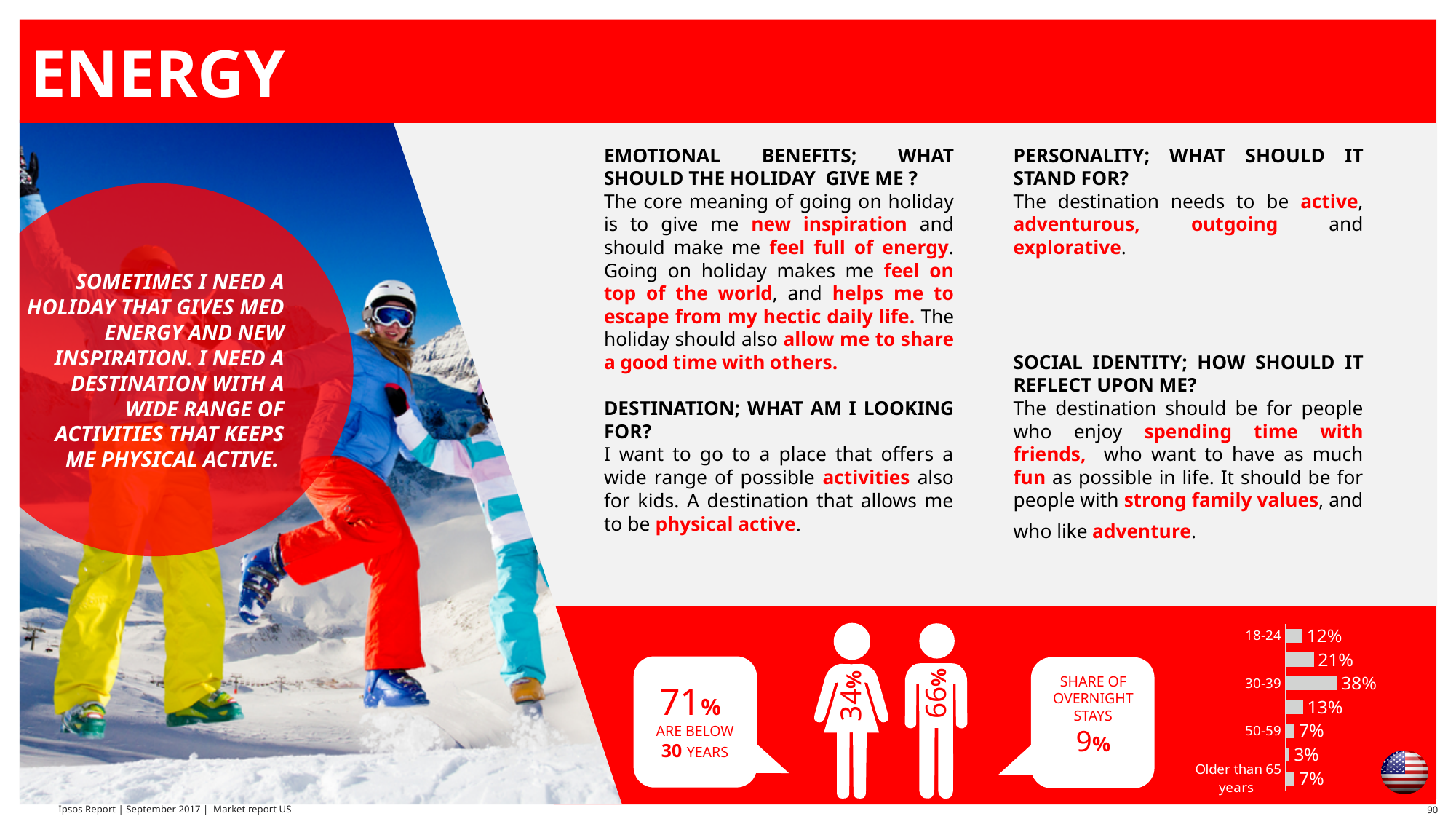
What type of chart is used to show the age-group distribution on the slide? bar chart In the age-group bar chart, what is the value for the 50-59 age group? 7% How many bars are shown in the age-group bar chart? 7 In the age-group bar chart, what is the value for the 18-24 age group? 12% In the age-group bar chart, what is the smallest value shown on any bar? 3% In the age-group bar chart, what is the difference between the 30-39 value and the 18-24 value? 26% In the age-group bar chart, what is the value for the 'Older than 65 years' group? 7% In the age-group bar chart, which labelled age group has the highest value? 30-39 In the age-group bar chart, which is larger: the value for 18-24 or the value for 50-59? 18-24 In the age-group bar chart, what is the value for the 30-39 age group? 38% In the age-group bar chart, what colour are the bars? grey In the age-group bar chart, are the bars drawn horizontally or vertically? horizontally